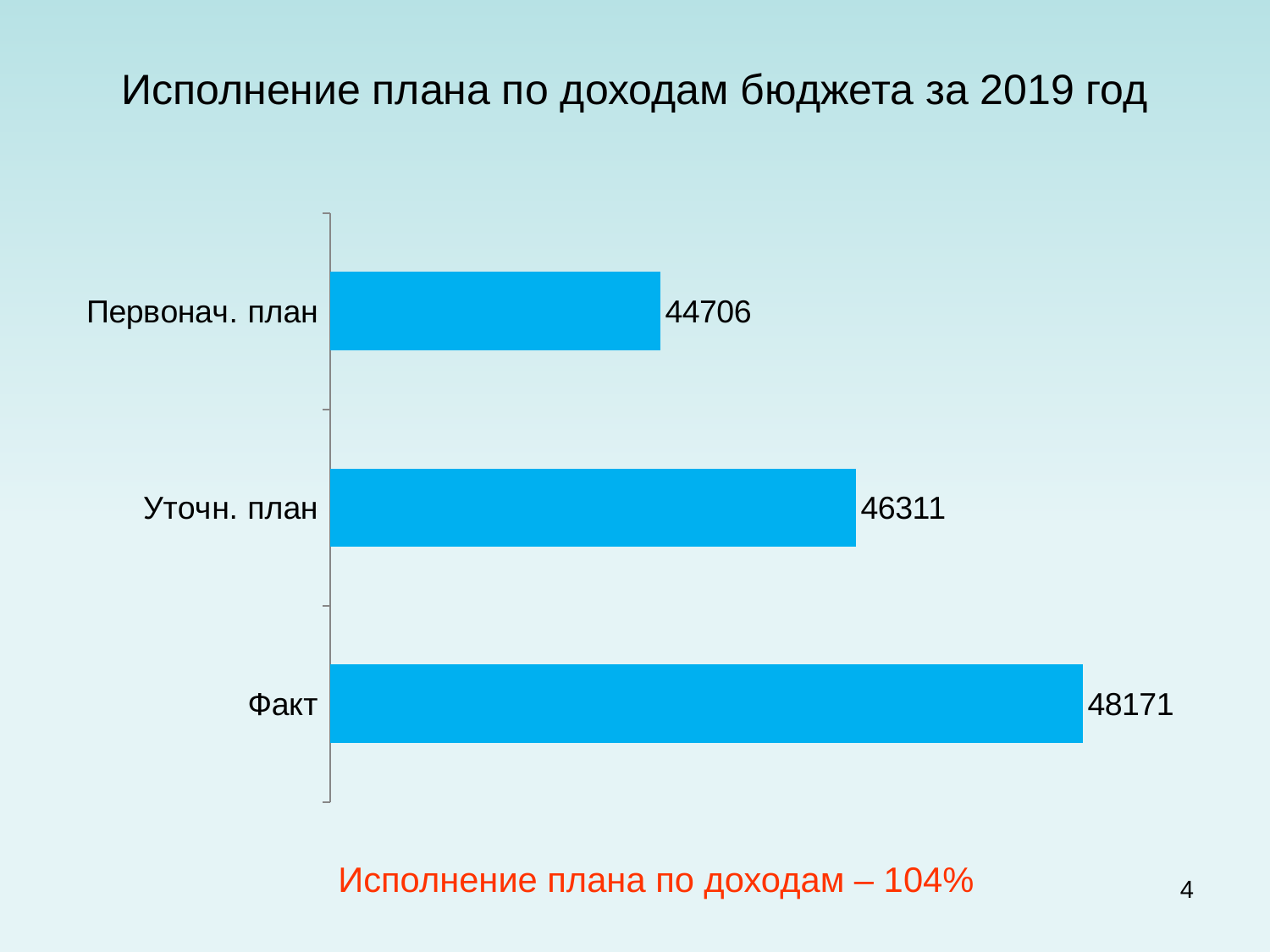
Which is larger, the value for Уточн. план or the value for Первонач. план? Уточн. план What kind of chart is shown on the slide? Bar chart What is the difference between the values for Факт and Первонач. план? 3465 What is the value for Уточн. план? 46311 What is the value for Факт? 48171 Which category has the highest value? Факт What is the difference between the values for Уточн. план and Первонач. план? 1605 Which category has the lowest value? Первонач. план How many categories are shown in the chart? 3 What is the title of the slide containing the chart? Исполнение плана по доходам бюджета за 2019 год What is the value for Первонач. план? 44706 What is the difference between the values for Факт and Уточн. план? 1860